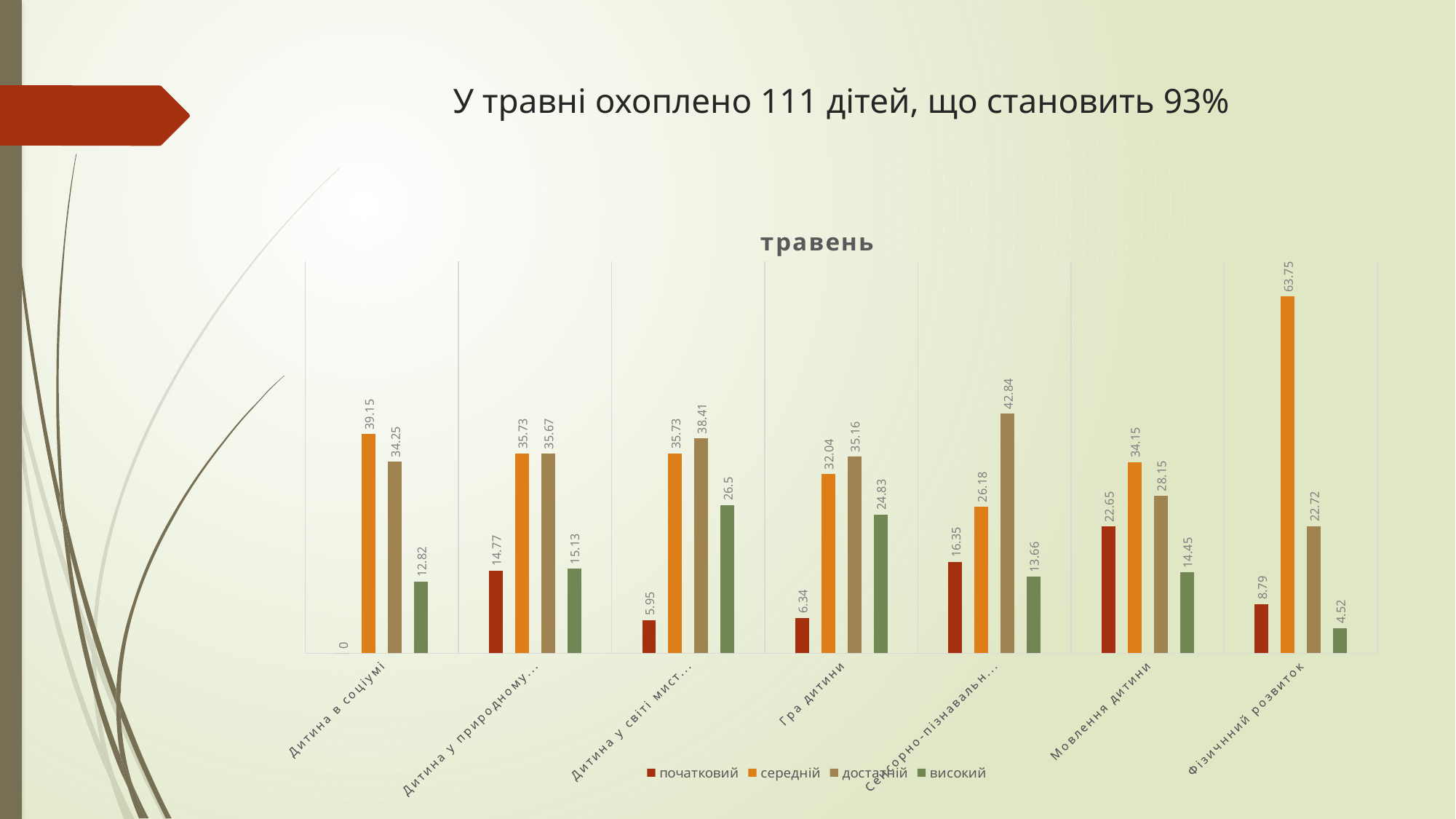
What is the value of the середній series for Фізичнний розвиток? 63.75 For Фізичнний розвиток, what is the difference between the середній and достатній values? 41.03 Which category has the highest value in the середній series? Фізичнний розвиток What is the value of the початковий series for Дитина в соціумі? 0 How many series does the legend list? 4 For Мовлення дитини, which is larger: the середній value or the достатній value? середній For Гра дитини, what is the difference between the достатній and середній values? 3.12 What is the value of the високий series for Гра дитини? 24.83 Which category has the highest value in the початковий series? Мовлення дитини What is the value of the початковий series for Мовлення дитини? 22.65 Which category has the lowest value in the високий series? Фізичнний розвиток How many categories are shown on the x axis of the chart? 7